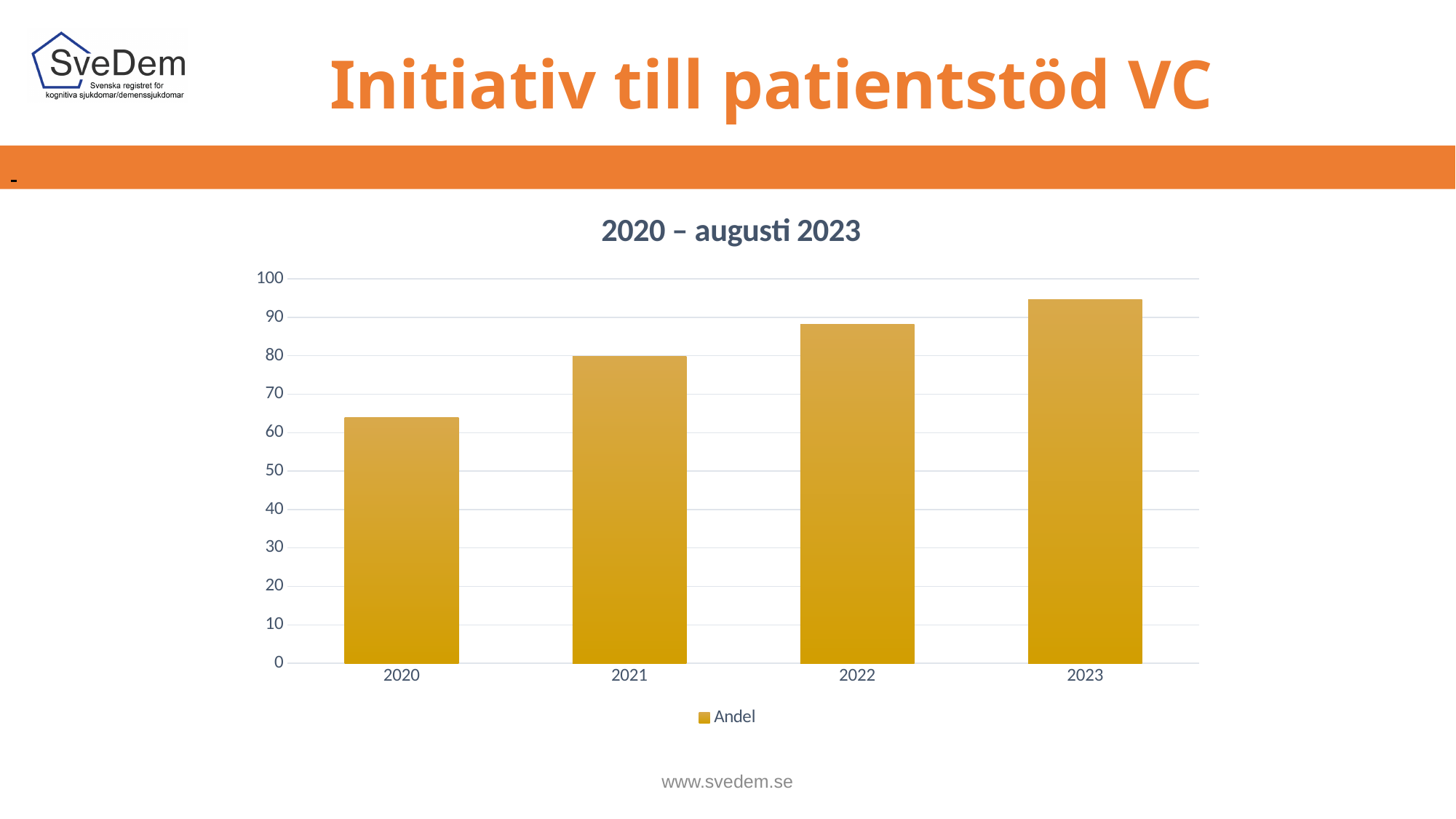
How many years are shown on the x axis? 4 Is the value for 2022 greater or less than 80? greater Which year has the highest value? 2023 What is the title of the chart? 2020 – augusti 2023 Is the value for 2020 greater or less than 70? less What is the name of the series in the legend? Andel What kind of chart is shown on the slide? bar chart Which year has the lowest value? 2020 Do the values rise or fall from 2020 to 2023? rise How many series does the legend list? 1 Which is larger, the value for 2021 or the value for 2022? 2022 Is the value for 2023 greater or less than 90? greater